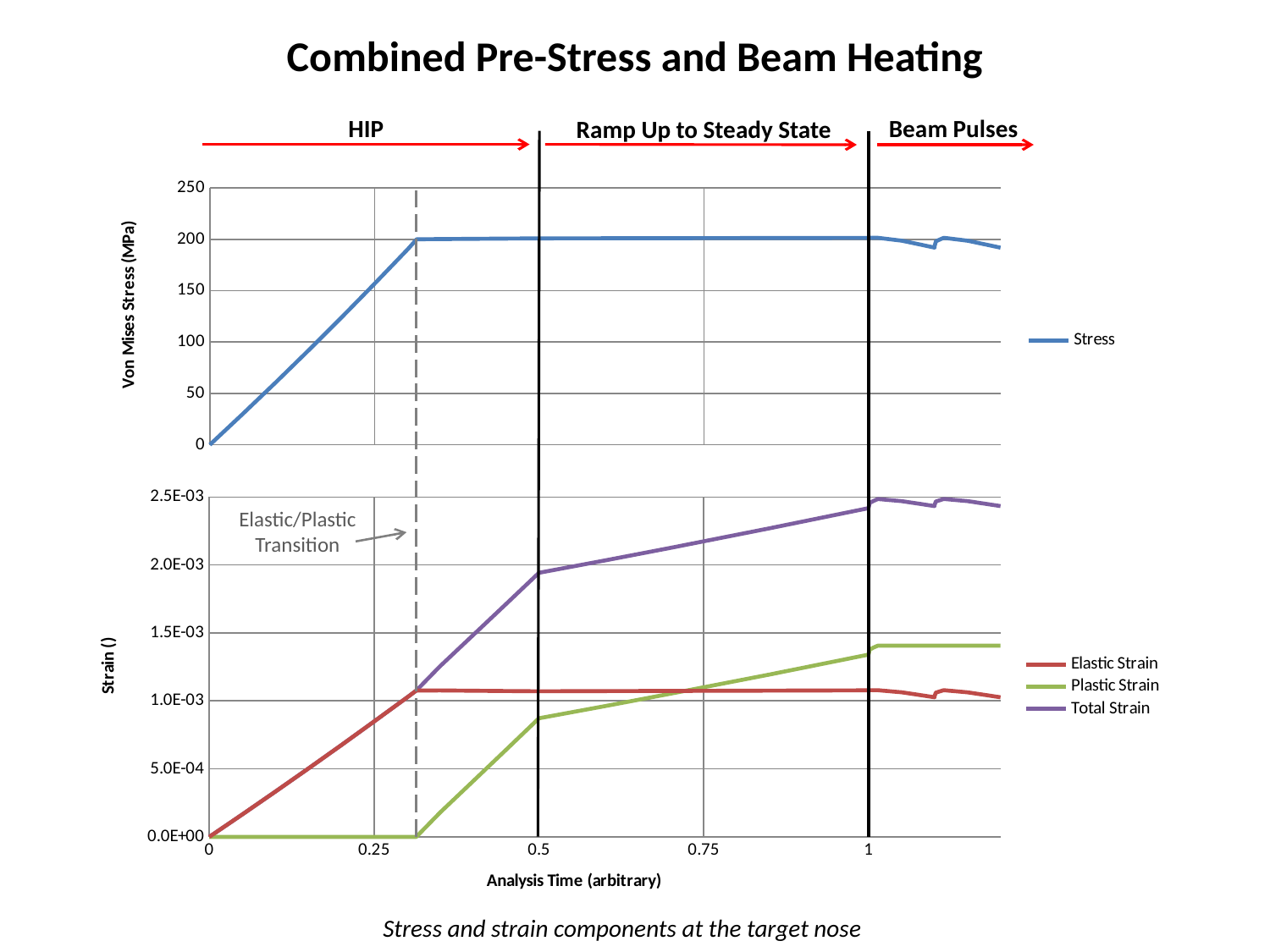
How many series does the legend of the bottom chart (Strain) list? 3 In the top chart (Von Mises Stress), what is the stress value at analysis time 0? 0 In the bottom chart (Strain), what are the three series named in the legend? Elastic Strain, Plastic Strain, Total Strain In the bottom chart (Strain), what is the Plastic Strain value at analysis time 0.25? 0.0E+00 In the top chart (Von Mises Stress), is the stress value at analysis time 0.25 greater or less than 100? greater In the bottom chart (Strain), is the Total Strain value at analysis time 1 greater or less than 2.0E-03? greater In the bottom chart (Strain), at analysis time 0.5, which is larger: Elastic Strain or Plastic Strain? Elastic Strain In the bottom chart (Strain), does the Plastic Strain rise or fall between analysis time 0.5 and 1? rise What is the title of the slide's chart? Combined Pre-Stress and Beam Heating What kind of chart is the top chart (Von Mises Stress)? line chart In the top chart (Von Mises Stress), is the stress value at analysis time 0.75 greater or less than 150? greater